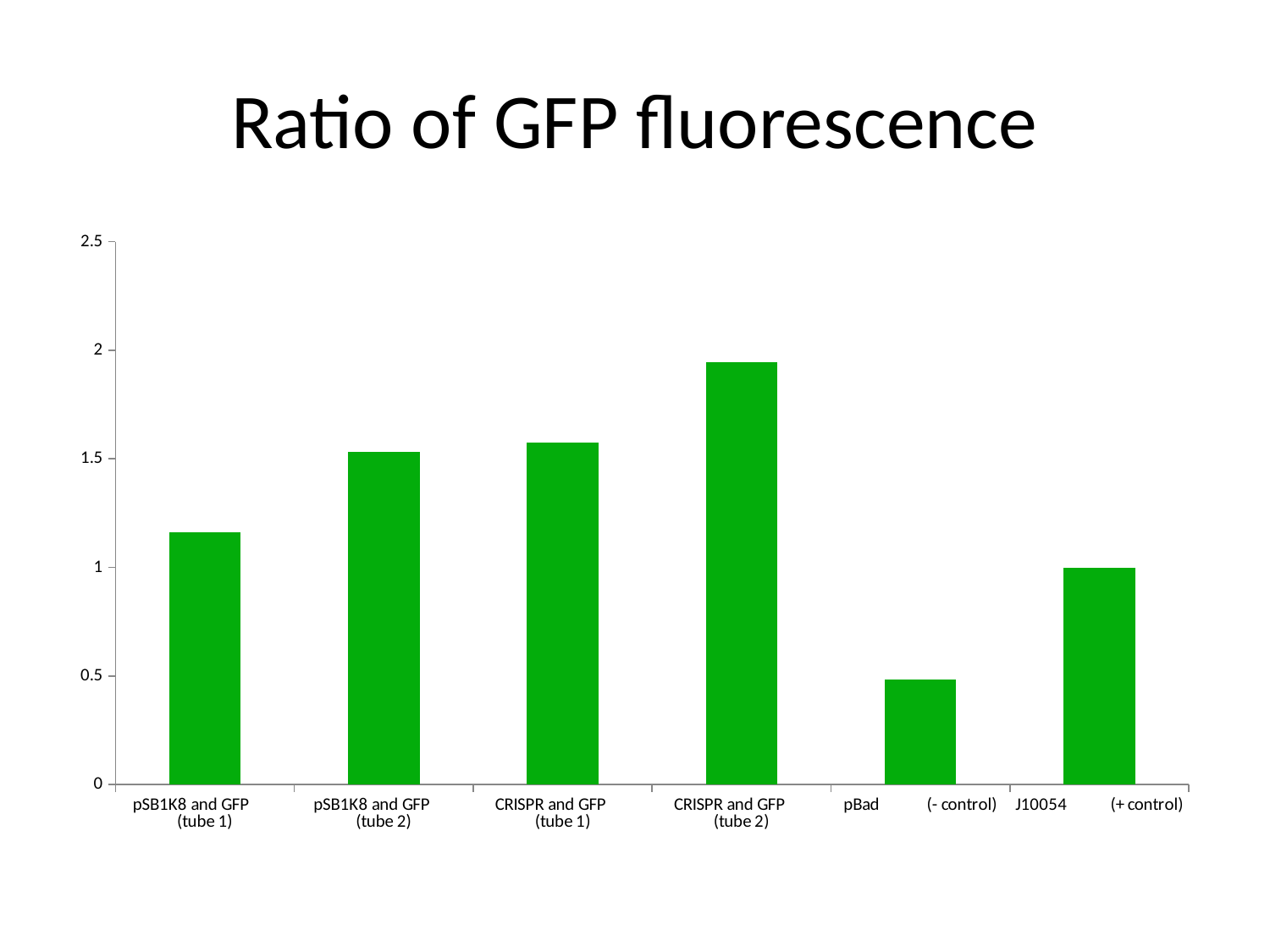
What kind of chart is shown on the slide? bar chart Which category has the highest ratio of GFP fluorescence? CRISPR and GFP (tube 2) Which category has the lowest ratio of GFP fluorescence? pBad (- control) Is the value for CRISPR and GFP (tube 2) greater or less than 2? less Which is larger, the value for pSB1K8 and GFP (tube 1) or the value for CRISPR and GFP (tube 1)? CRISPR and GFP (tube 1) Is the value for pSB1K8 and GFP (tube 2) greater or less than 1? greater How many bars are plotted in the chart? 6 What is the title of the chart? Ratio of GFP fluorescence What colour are the bars in the chart? green Is the value for pSB1K8 and GFP (tube 1) greater or less than 1? greater Which is larger, the value for J10054 (+ control) or the value for pBad (- control)? J10054 (+ control)